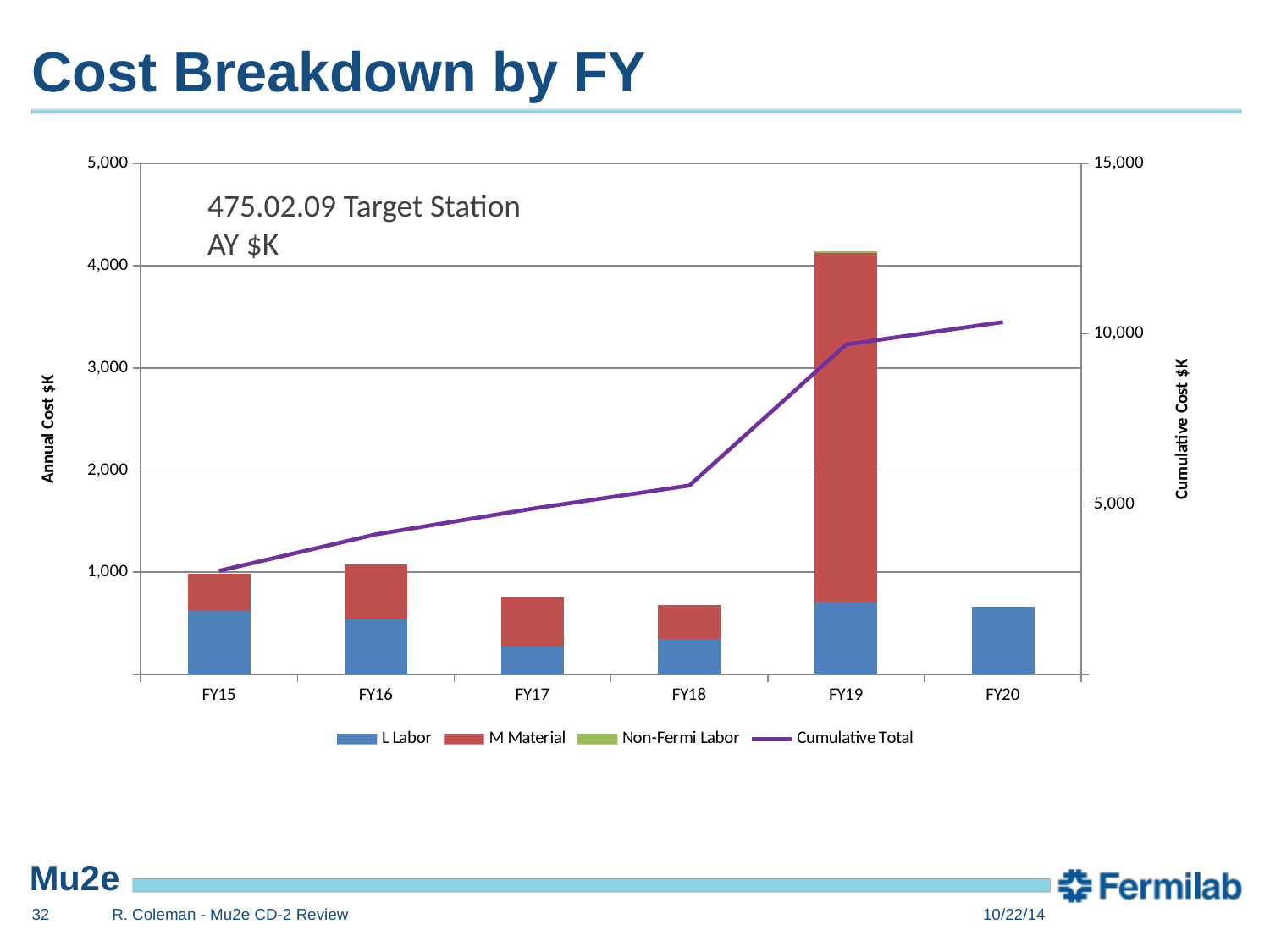
Is the Cumulative Total at FY15 greater or less than 5,000 on the right axis? less Does the Cumulative Total line rise or fall from FY15 to FY20? rise Which has the larger total stacked bar, FY15 or FY19? FY19 Is the total stacked bar for FY19 greater or less than 4,000? greater Is the Cumulative Total at FY18 greater or less than 5,000 on the right axis? greater What kind of chart is shown on the slide? bar chart with a line How many fiscal years are shown on the x axis? 6 Which fiscal year has the tallest stacked bar? FY19 What is the label on the right-hand vertical axis? Cumulative Cost $K How many series does the legend list? 4